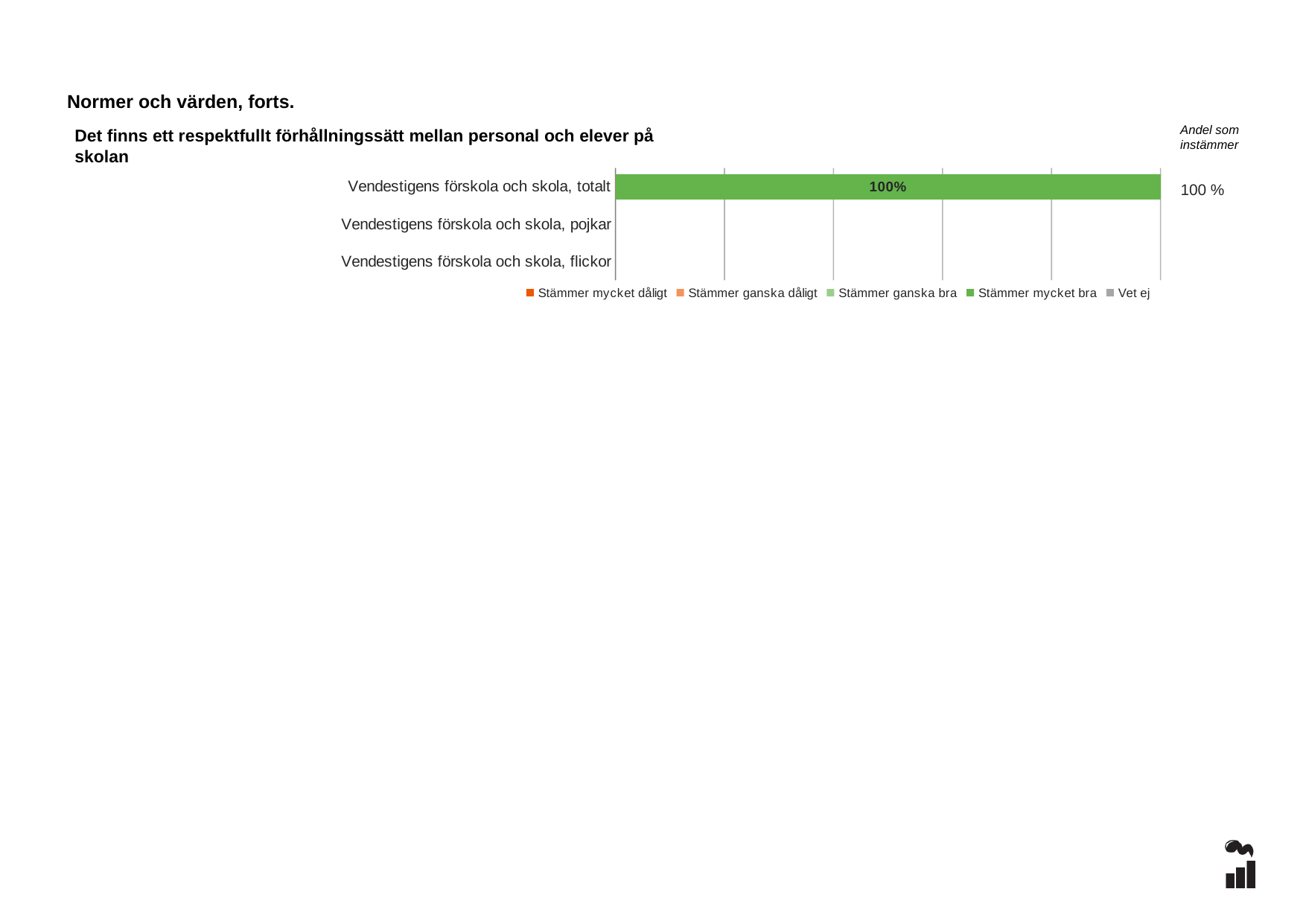
How many series does the chart legend list? 5 Which legend series does the bar for "Vendestigens förskola och skola, totalt" belong to? Stämmer mycket bra What is the "Andel som instämmer" value shown for "Vendestigens förskola och skola, totalt"? 100 % What is the value labelled on the bar for "Vendestigens förskola och skola, totalt"? 100% What kind of chart is shown on the slide? bar chart What is the last entry in the chart legend? Vet ej How many categories are listed on the vertical axis of the chart? 3 What is the total of the stacked bar for "Vendestigens förskola och skola, totalt"? 100% What is the first entry in the chart legend? Stämmer mycket dåligt Is the value for "Vendestigens förskola och skola, totalt" greater or less than 50%? greater Which category has the highest value in the chart? Vendestigens förskola och skola, totalt